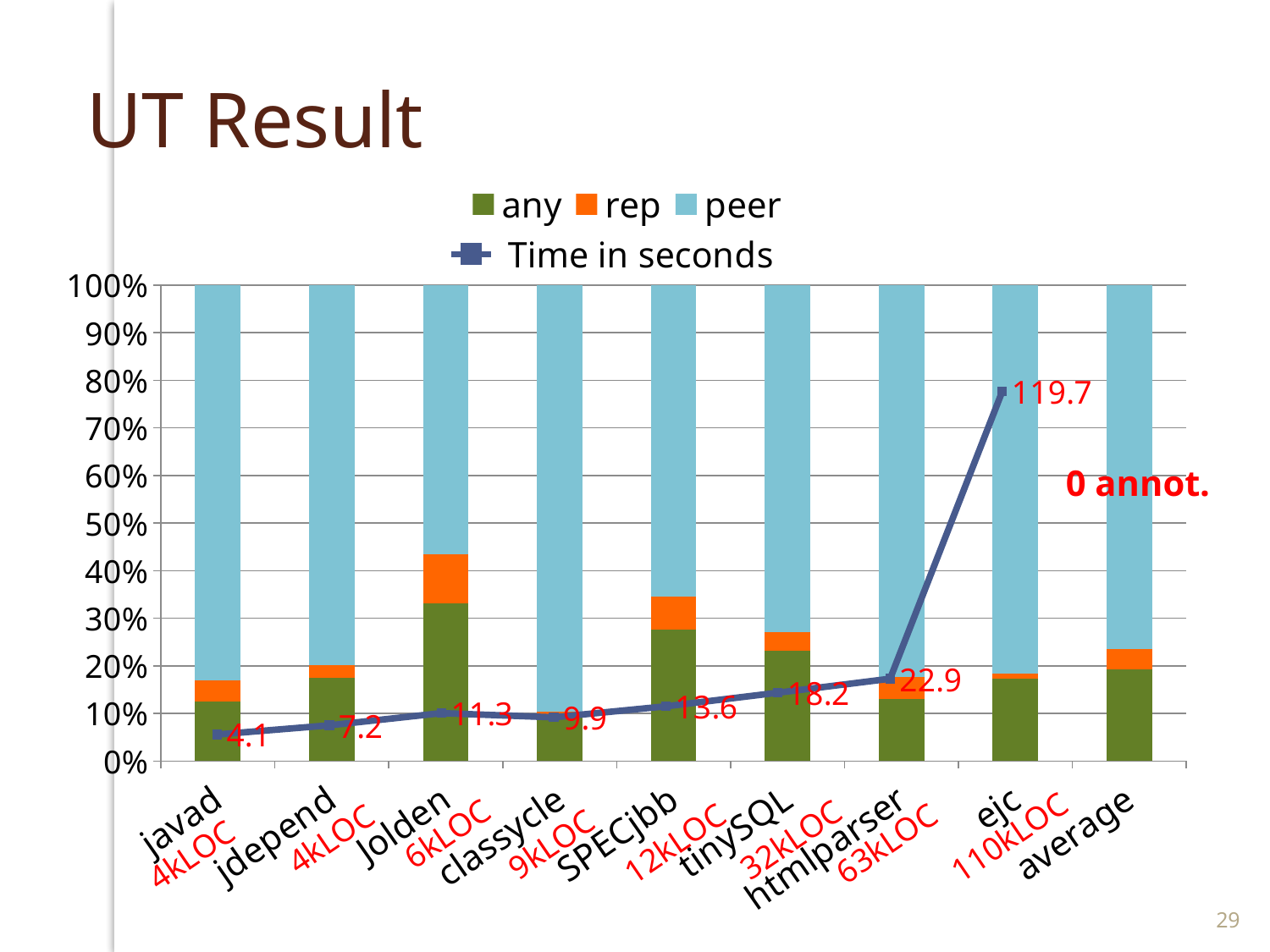
Does the Time in seconds rise or fall from SPECjbb to ejc? rise What is the Time in seconds value for ejc? 119.7 How many categories are shown on the x axis? 9 What is the Time in seconds value for htmlparser? 22.9 What is the Time in seconds value for javad? 4.1 Which has a larger Time in seconds, Jolden or classycle? Jolden Is the 'any' share for Jolden greater or less than 30%? greater Which category has the highest Time in seconds? ejc Which category has the lowest Time in seconds? javad What is the difference in Time in seconds between htmlparser and tinySQL? 4.7 How many series does the legend list? 4